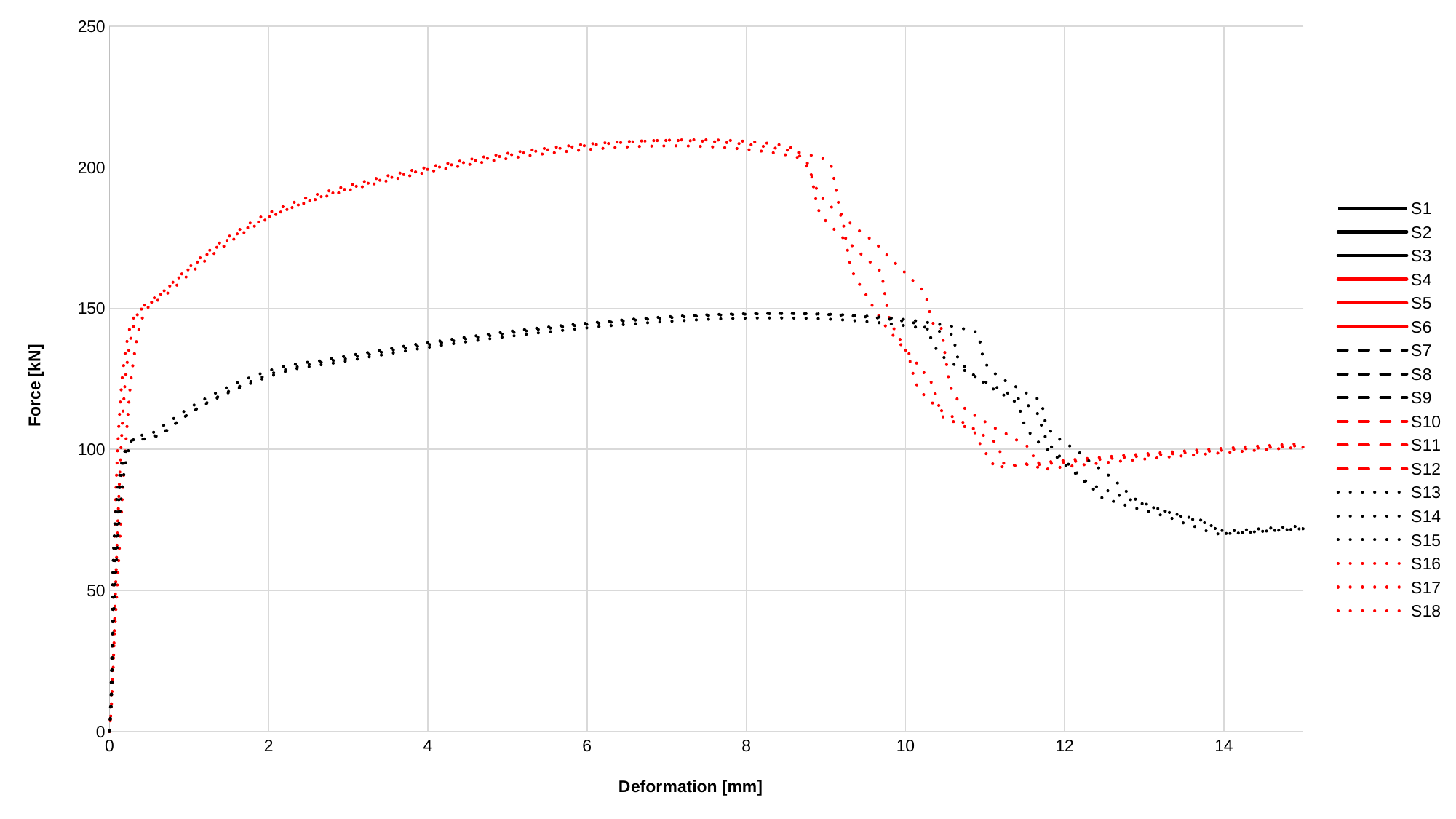
What is the title of the y axis? Force [kN] Is the peak force reached by the black curves greater or less than 200 kN? less At a deformation of 14 mm, is the force of the black curves greater or less than 100 kN? less At a deformation of 2 mm, is the force of the black curves greater or less than 150 kN? less Do the red curves rise or fall as deformation increases from 0 mm to 6 mm? rise Do the black curves rise or fall as deformation increases from 10 mm to 14 mm? fall How many series does the legend list? 18 What kind of chart is shown on the slide? line chart At a deformation of 6 mm, which curves show the higher force, the red ones or the black ones? the red ones What is the title of the x axis? Deformation [mm]